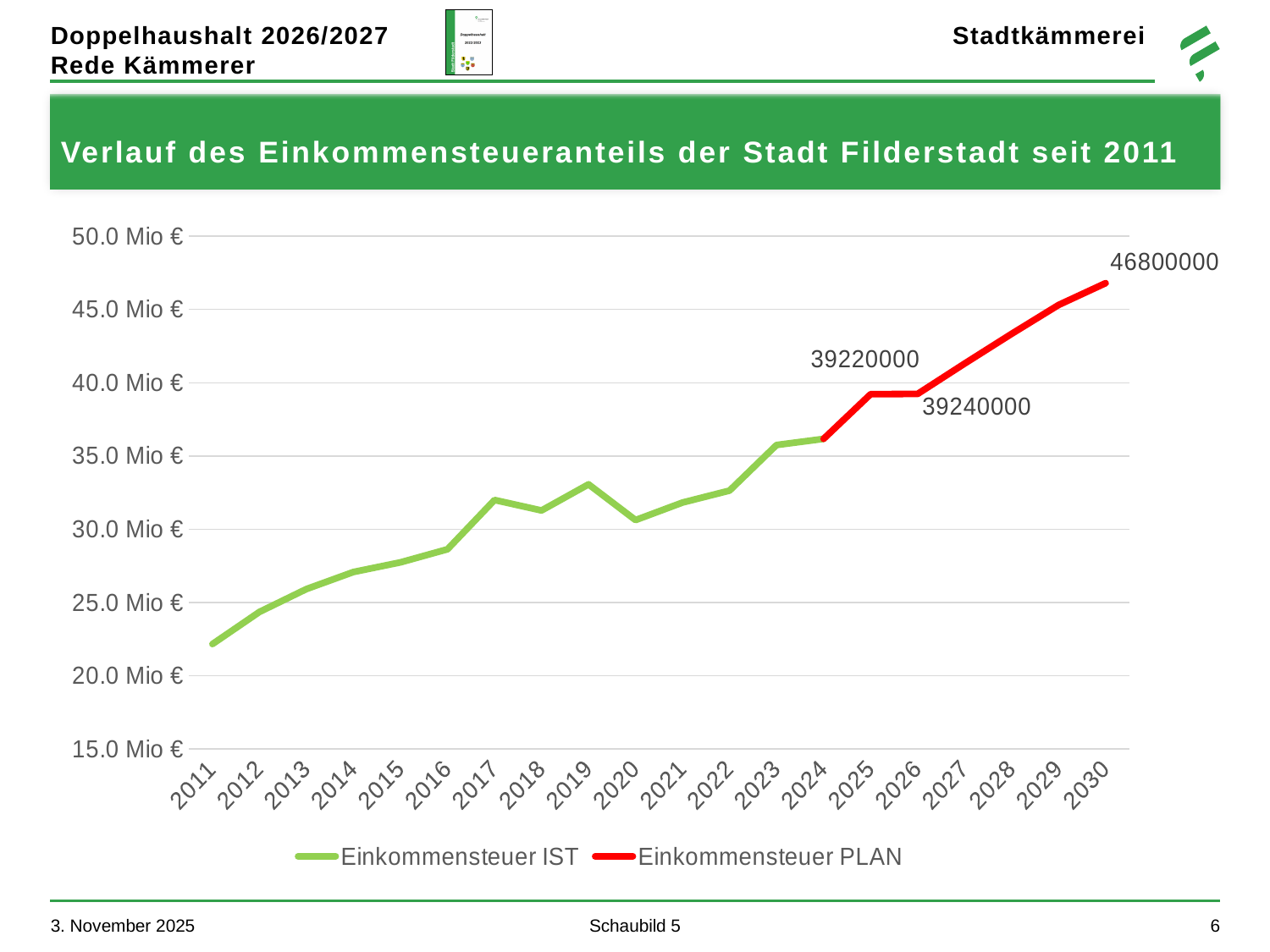
What is the value of Einkommensteuer PLAN for 2025? 39220000 What is the difference between the Einkommensteuer PLAN values for 2030 and 2026? 7560000 Which is larger, the Einkommensteuer PLAN value for 2025 or for 2026? 2026 What is the value of Einkommensteuer PLAN for 2026? 39240000 Which year has the highest value on the chart? 2030 How many years are shown on the x axis? 20 Which year has the lowest value on the chart? 2011 Is the Einkommensteuer IST value for 2011 greater or less than 25.0 Mio €? less Is the Einkommensteuer IST value for 2019 greater or less than 30.0 Mio €? greater What is the value of Einkommensteuer PLAN for 2030? 46800000 How many series does the legend list? 2 What kind of chart is shown on the slide? line chart